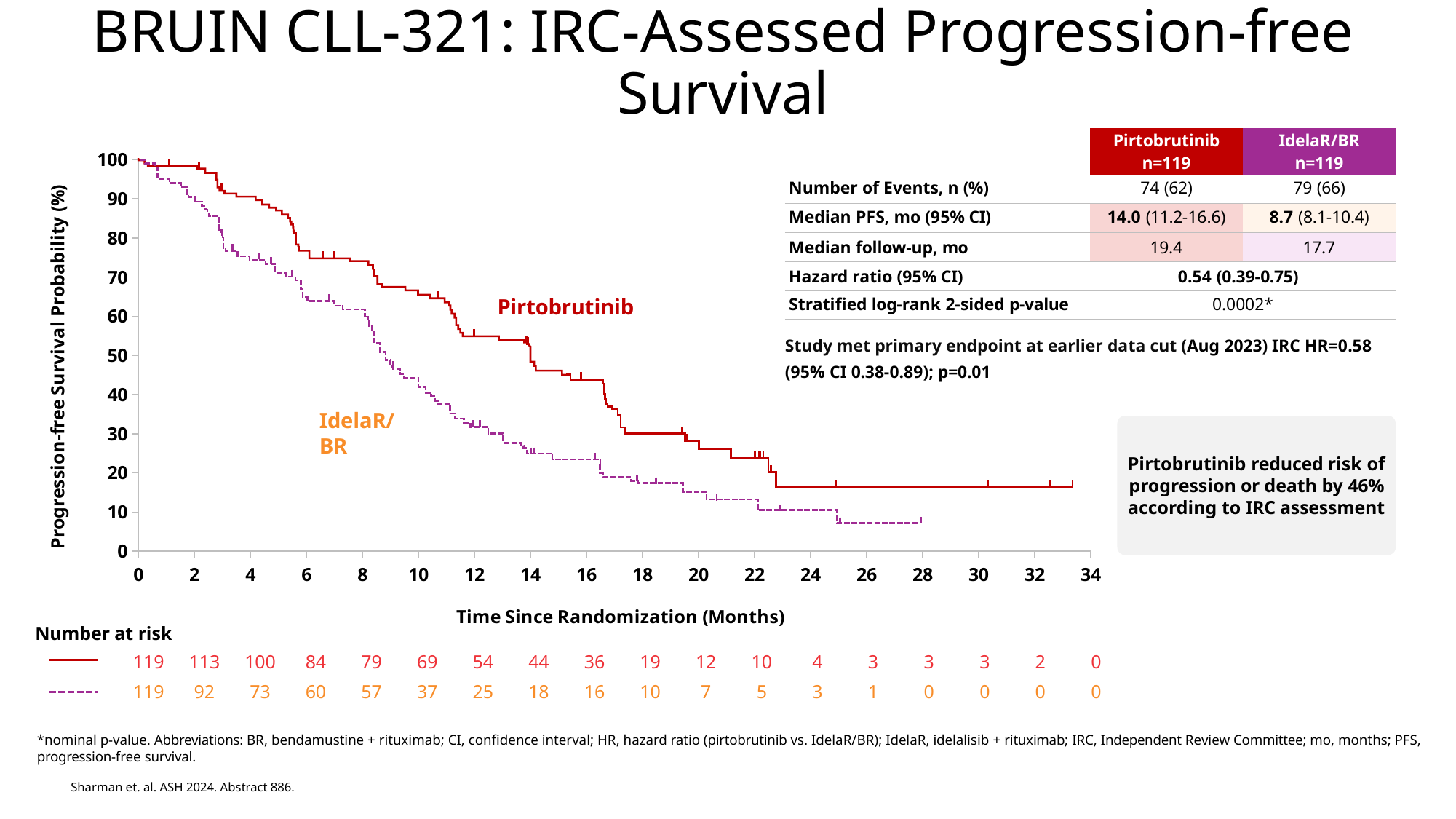
What kind of chart is shown on the slide? Line chart (Kaplan-Meier survival curve) What is the difference in number at risk between the Pirtobrutinib and IdelaR/BR arms at 4 months? 27 Is the progression-free survival probability for Pirtobrutinib at 10 months greater or less than 60%? greater Do the progression-free survival curves rise or fall as time since randomization increases? Fall What is the number at risk for the Pirtobrutinib arm at 10 months? 69 What is the label of the x axis? Time Since Randomization (Months) Which treatment arm is drawn with a dashed line? IdelaR/BR What is the median PFS in months for the Pirtobrutinib arm? 14.0 What is the median PFS in months for the IdelaR/BR arm? 8.7 Which arm has the higher number at risk at 14 months? Pirtobrutinib How many treatment arms (series) are plotted on the chart? 2 What is the number at risk for the IdelaR/BR arm at 6 months? 60